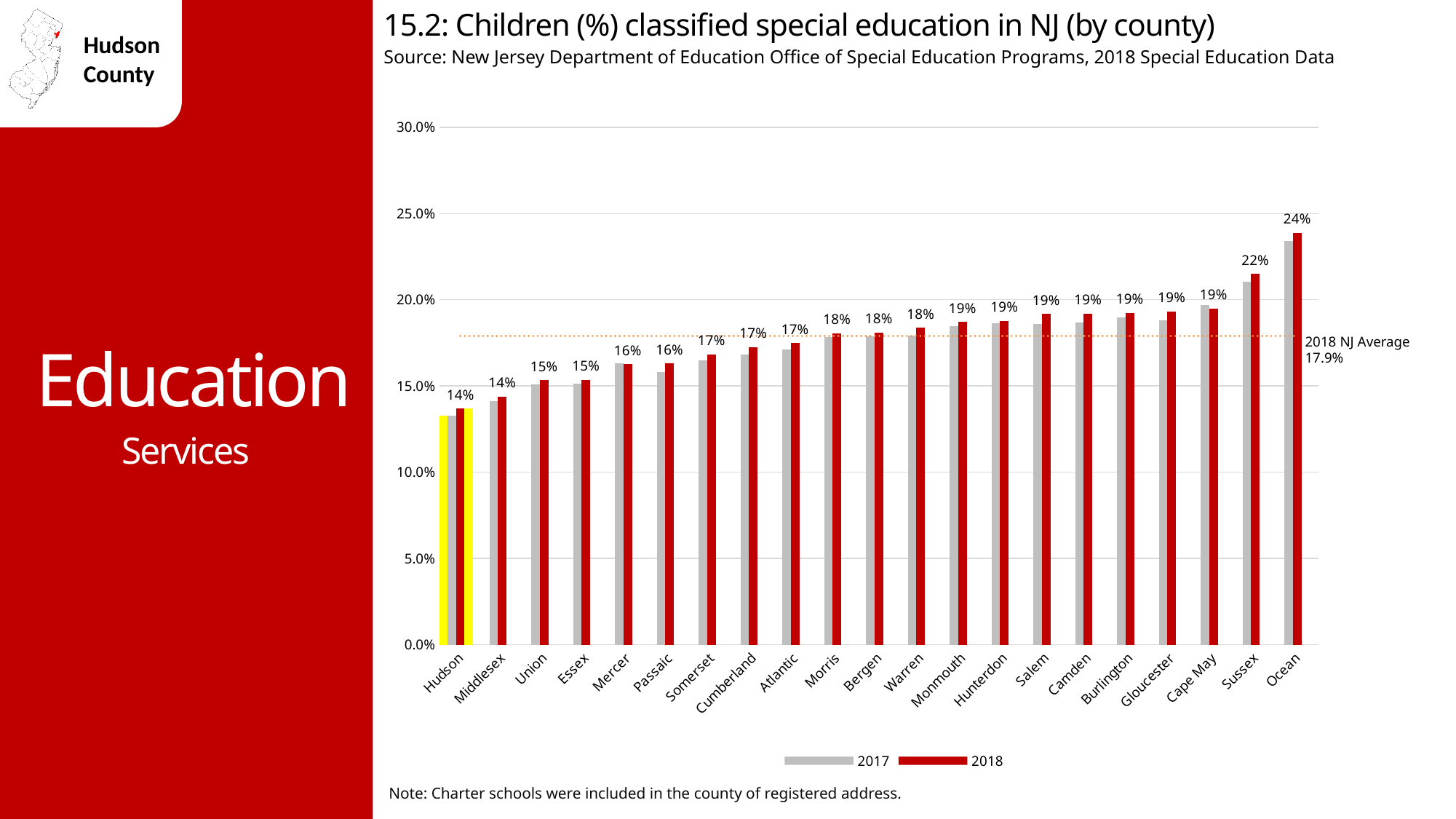
Is the 2017 value for Hudson county greater or less than 15.0%? less What is the difference between the labelled 2018 values for Ocean and Hudson? 10 percentage points Which has the larger labelled 2018 value, Sussex or Cape May? Sussex What is the labelled 2018 value for Sussex county? 22% How many series does the chart legend list? 2 How many counties are shown on the x axis of the chart? 21 Do the values generally rise or fall moving from left to right along the x axis? Rise Which county has the highest percentage of children classified special education in 2018? Ocean What is the labelled 2018 value for Ocean county? 24% What kind of chart is shown on the slide? Bar chart What is the labelled 2018 value for Hudson county? 14% What is the 2018 NJ Average shown by the dotted line on the chart? 17.9%